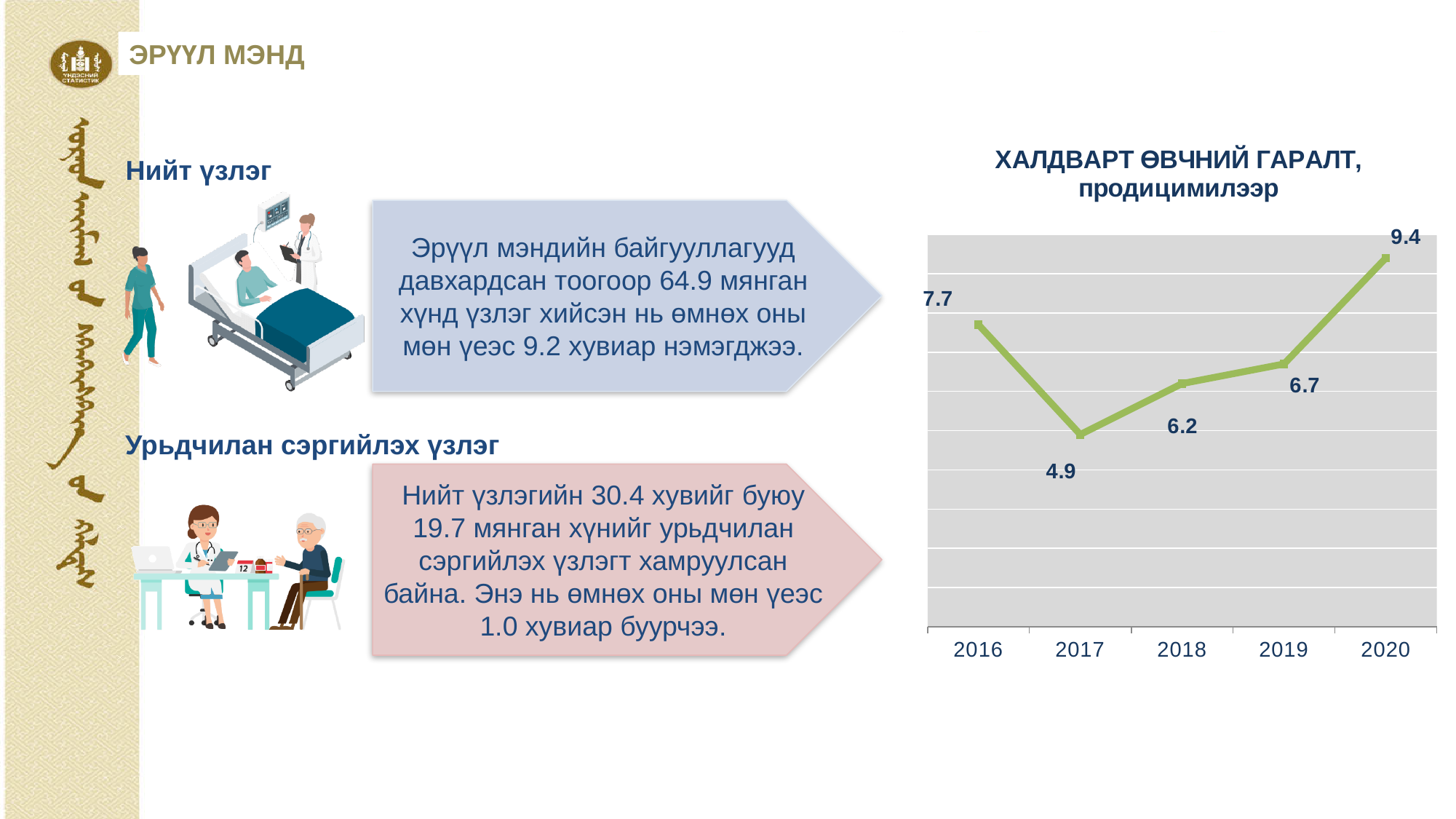
What is the value for 2018 in the chart? 6.2 What is the value for 2016 in the chart? 7.7 What is the value for 2017 in the chart? 4.9 What is the difference between the values for 2020 and 2016? 1.7 Which year has the lowest value in the chart? 2017 How many years are plotted in the chart? 5 What kind of chart is shown on the slide? line chart What is the value for 2019 in the chart? 6.7 Do the values rise or fall from 2017 to 2020? rise Which is larger, the value for 2018 or the value for 2019? 2019 What is the value for 2020 in the chart? 9.4 Which year has the highest value in the chart? 2020